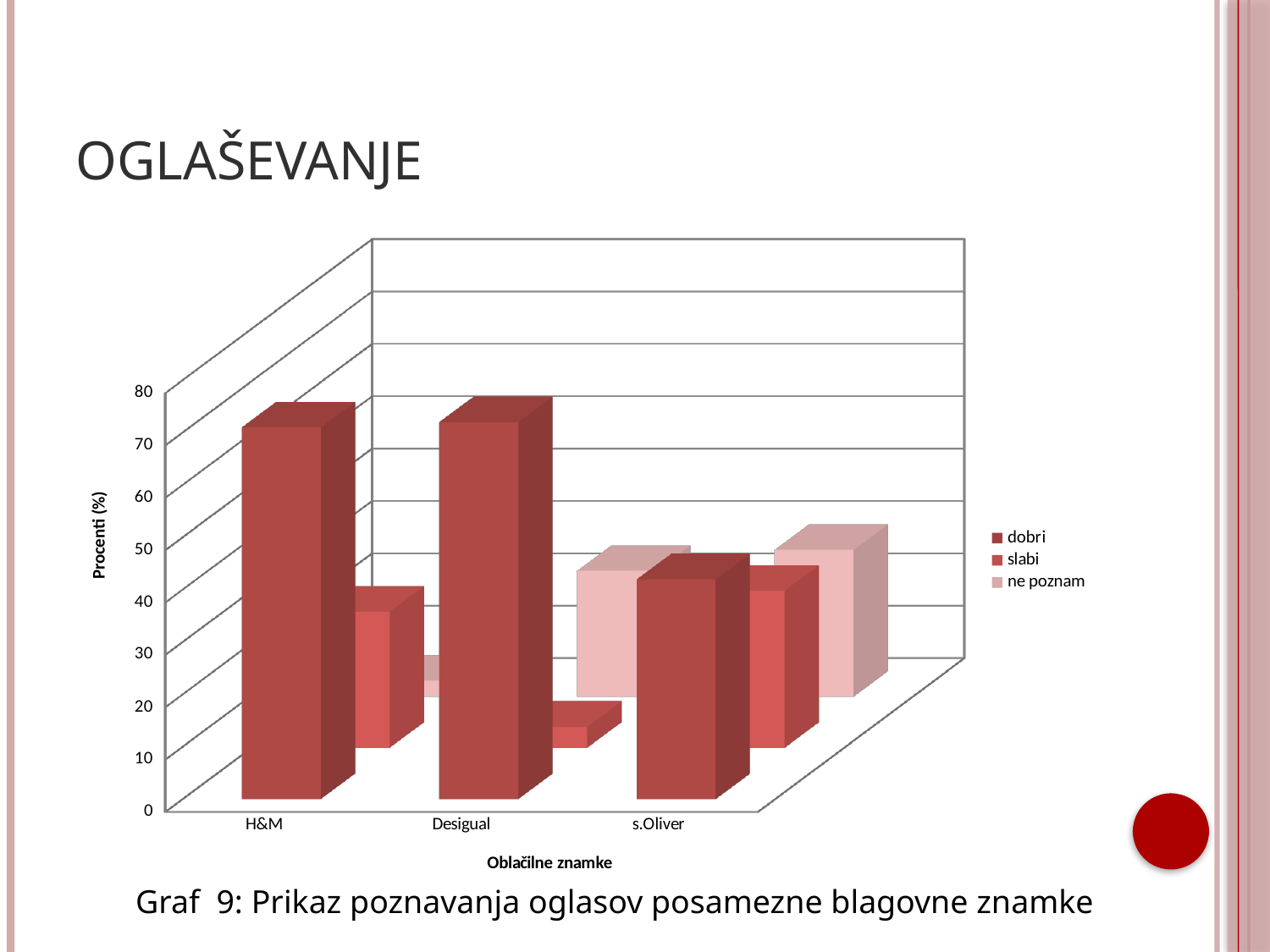
What is the title of the vertical axis? Procenti (%) How many series does the legend list? 3 Which brand has the lowest value for the 'dobri' series? s.Oliver Which is larger: the 'slabi' value for Desigual or the 'slabi' value for s.Oliver? s.Oliver What type of chart is shown on the slide? bar chart Which is larger: the 'dobri' value for H&M or the 'dobri' value for s.Oliver? H&M Is the 'dobri' value for H&M greater or less than 50? greater Which brand has the lowest value for the 'slabi' series? Desigual How many clothing brands (categories) are shown on the x axis? 3 Which is larger: the 'ne poznam' value for H&M or the 'ne poznam' value for Desigual? Desigual Is the 'dobri' value for s.Oliver greater or less than 60? less Is the 'slabi' value for Desigual greater or less than 30? less